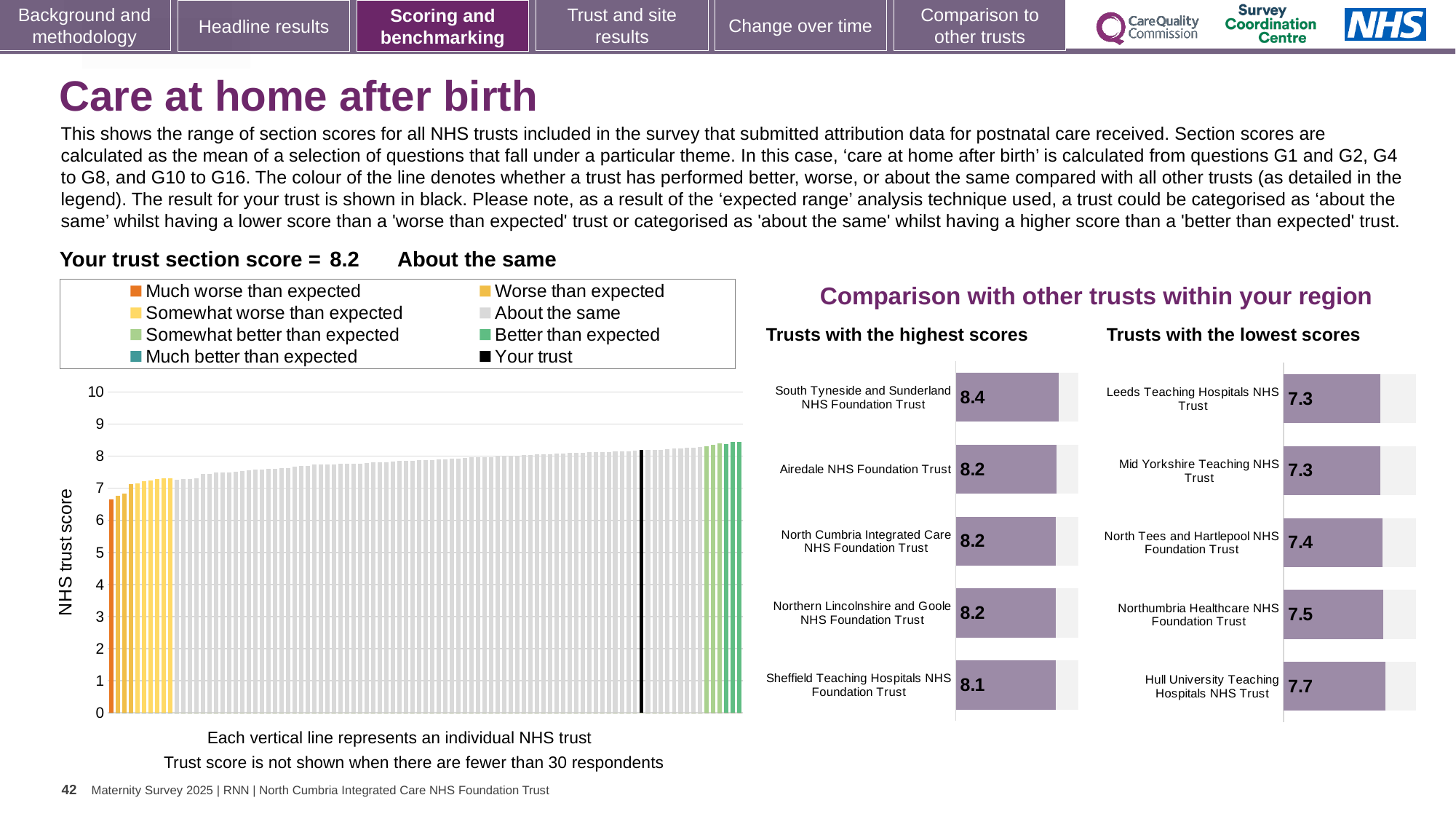
In the 'Trusts with the lowest scores' chart, what is the score for Hull University Teaching Hospitals NHS Trust? 7.7 How many entries does the legend of the NHS trust score chart on the left list? 8 What kind of chart is the NHS trust score chart on the left of the slide? bar chart How many trusts are shown in the 'Trusts with the highest scores' chart? 5 In the 'Trusts with the lowest scores' chart, what is the difference between the scores of Hull University Teaching Hospitals NHS Trust and Leeds Teaching Hospitals NHS Trust? 0.4 In the 'Trusts with the lowest scores' chart, which has the larger score: Northumbria Healthcare NHS Foundation Trust or North Tees and Hartlepool NHS Foundation Trust? Northumbria Healthcare NHS Foundation Trust In the NHS trust score chart on the left, do the values rise or fall from left to right along the x axis? rise What is the section score for your trust shown above the NHS trust score chart? 8.2 In the 'Trusts with the highest scores' chart, what is the score for South Tyneside and Sunderland NHS Foundation Trust? 8.4 In the 'Trusts with the highest scores' chart, what is the difference between the scores of South Tyneside and Sunderland NHS Foundation Trust and Sheffield Teaching Hospitals NHS Foundation Trust? 0.3 In the 'Trusts with the lowest scores' chart, which trust has the highest score shown? Hull University Teaching Hospitals NHS Trust In the 'Trusts with the highest scores' chart, which trust has the highest score? South Tyneside and Sunderland NHS Foundation Trust